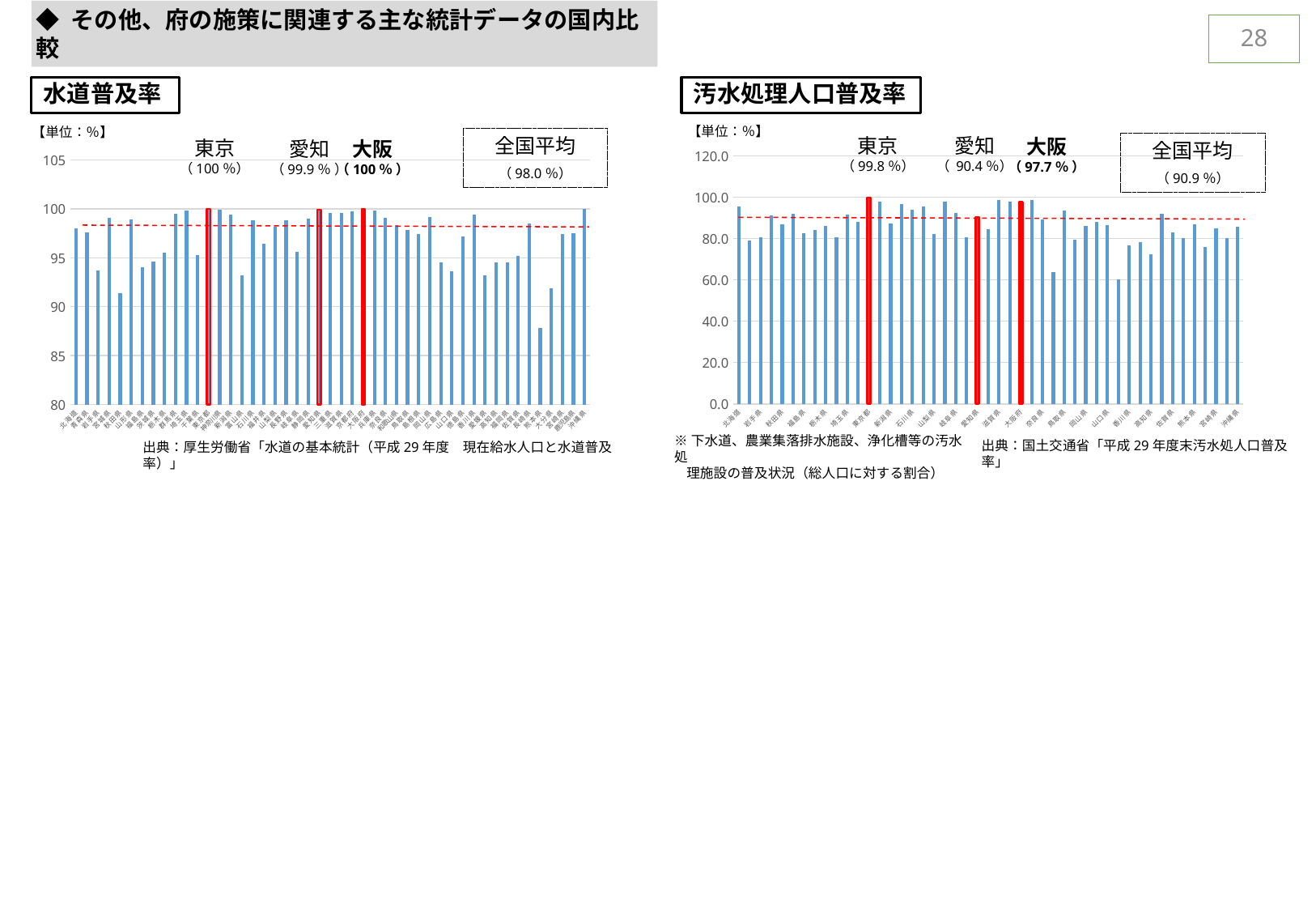
In the 汚水処理人口普及率 chart, what is the 全国平均 (national average) shown? 90.9 % In the 汚水処理人口普及率 chart, which is larger, the value for 大阪 or the 全国平均? 大阪 In the 汚水処理人口普及率 chart, what is the difference between the values for 東京 and 愛知? 9.4 % In the 水道普及率 chart, what is the 全国平均 (national average) shown? 98.0 % In the 水道普及率 chart, what is the value for 東京? 100 % In the 水道普及率 chart, what is the value for 愛知? 99.9 % In the 汚水処理人口普及率 chart, is the value for 愛知 greater or less than 100.0? less In the 汚水処理人口普及率 chart, what is the value for 愛知? 90.4 % In the 水道普及率 chart, is the value for 愛知 greater or less than the 全国平均 of 98.0 %? greater What kind of chart is the 水道普及率 chart? bar chart In the 汚水処理人口普及率 chart, what is the value for 大阪? 97.7 % In the 汚水処理人口普及率 chart, what colour are the bars for 東京, 愛知 and 大阪? red